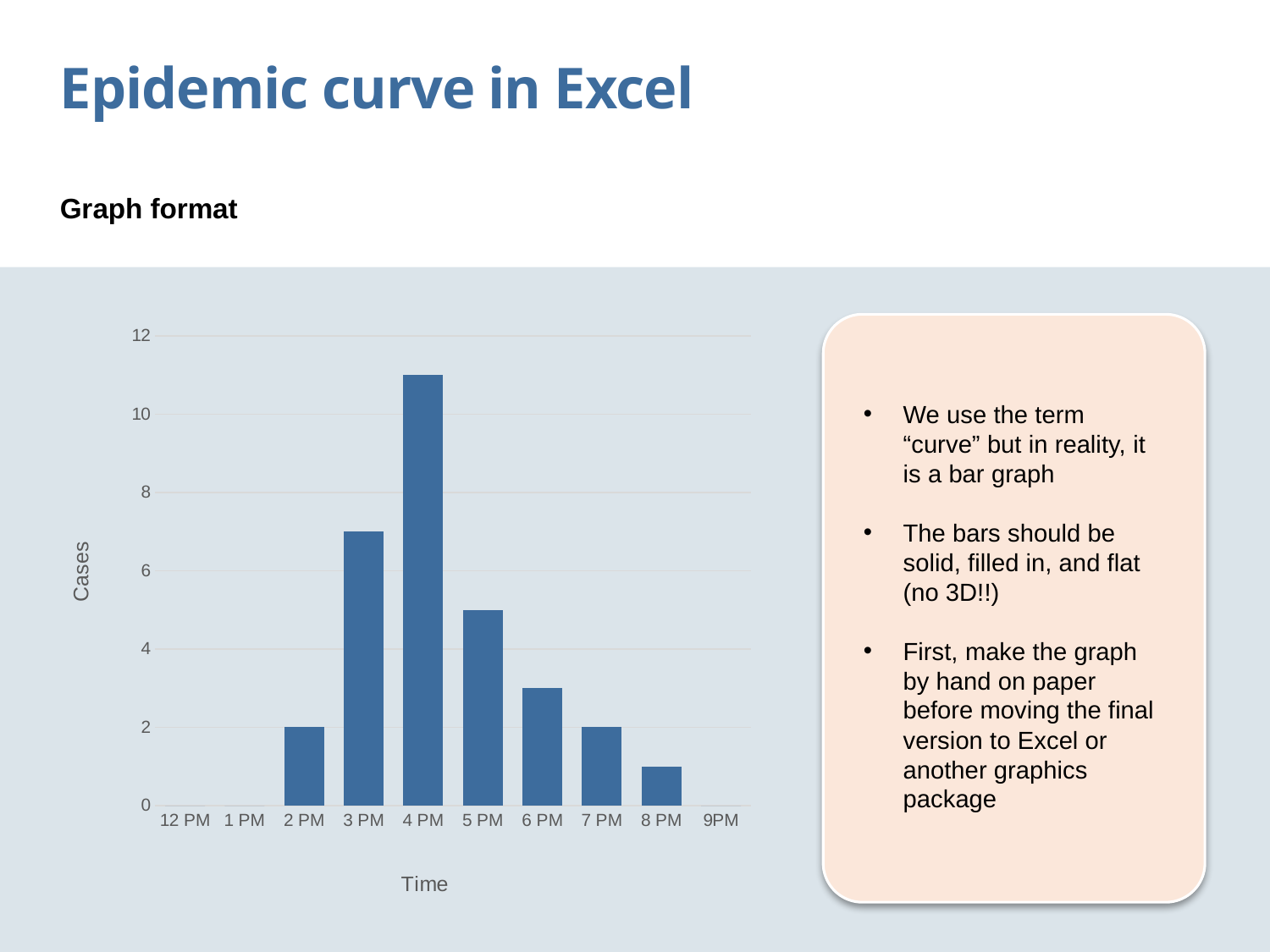
Is the value for 3 PM greater or less than 6? greater Is the value for 6 PM greater or less than 4? less Which has more cases, 3 PM or 5 PM? 3 PM How many cases are shown for 2 PM? 2 Is the value for 4 PM greater or less than 10? greater Do the values rise or fall from 4 PM to 8 PM? fall Which time has the highest number of cases? 4 PM What is the label on the vertical axis of the chart? Cases How many cases are shown for 7 PM? 2 What kind of chart is shown on the slide? bar chart Among the times with a bar, which has the lowest number of cases? 8 PM How many time labels are shown on the x axis? 10